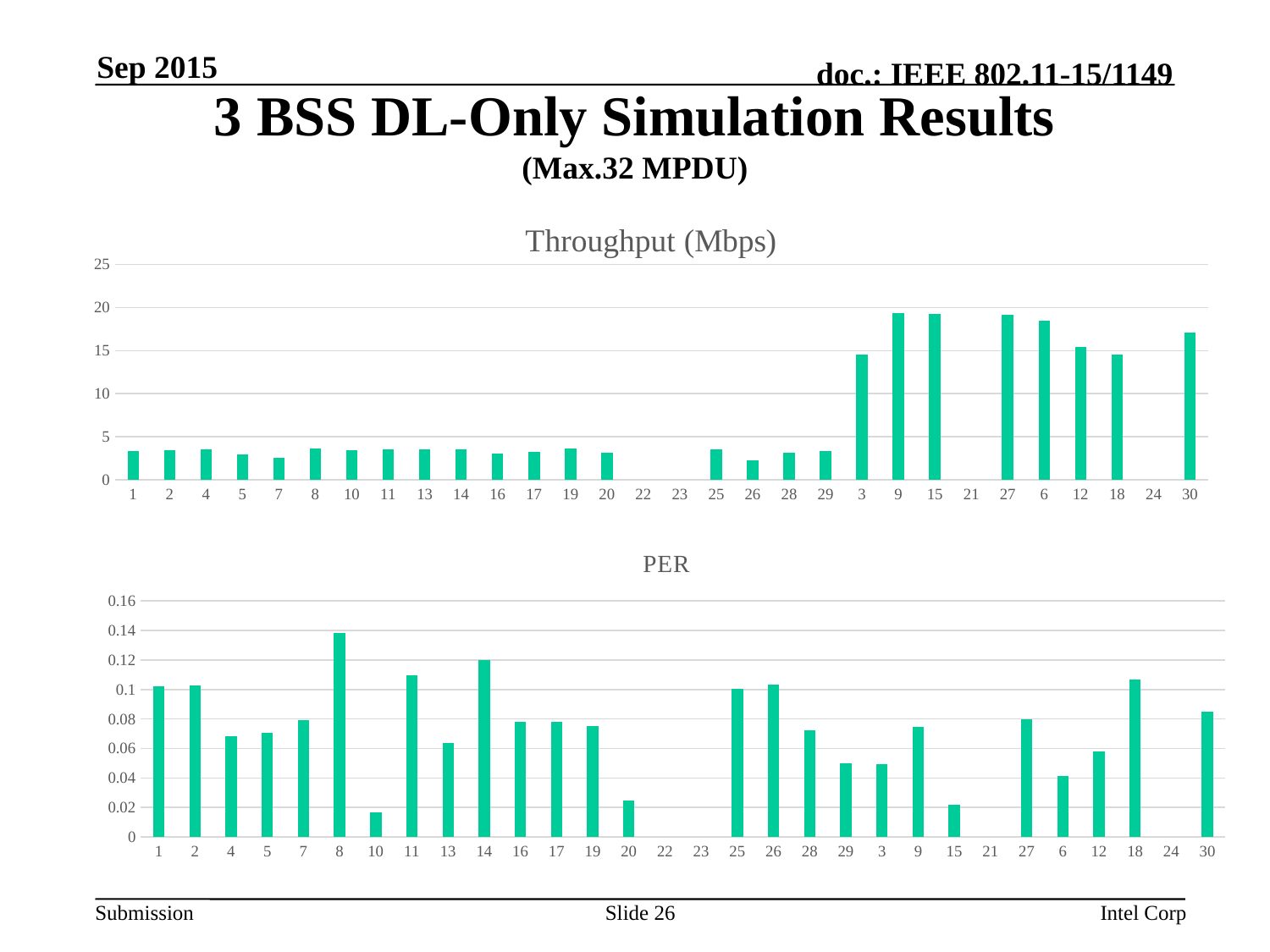
How many categories are shown on the x axis of the Throughput (Mbps) chart? 30 In the Throughput (Mbps) chart, is the value for category 1 greater or less than 5? less In the PER chart, which has the larger value, category 30 or category 6? 30 In the PER chart, which category has the highest value? 8 What kind of chart is the PER chart? bar chart In the PER chart, is the value for category 8 greater or less than 0.12? greater In the Throughput (Mbps) chart, which has the larger value, category 3 or category 1? 3 In the Throughput (Mbps) chart, which has the larger value, category 30 or category 26? 30 In the Throughput (Mbps) chart, is the value for category 9 greater or less than 15? greater What kind of chart is the Throughput (Mbps) chart? bar chart